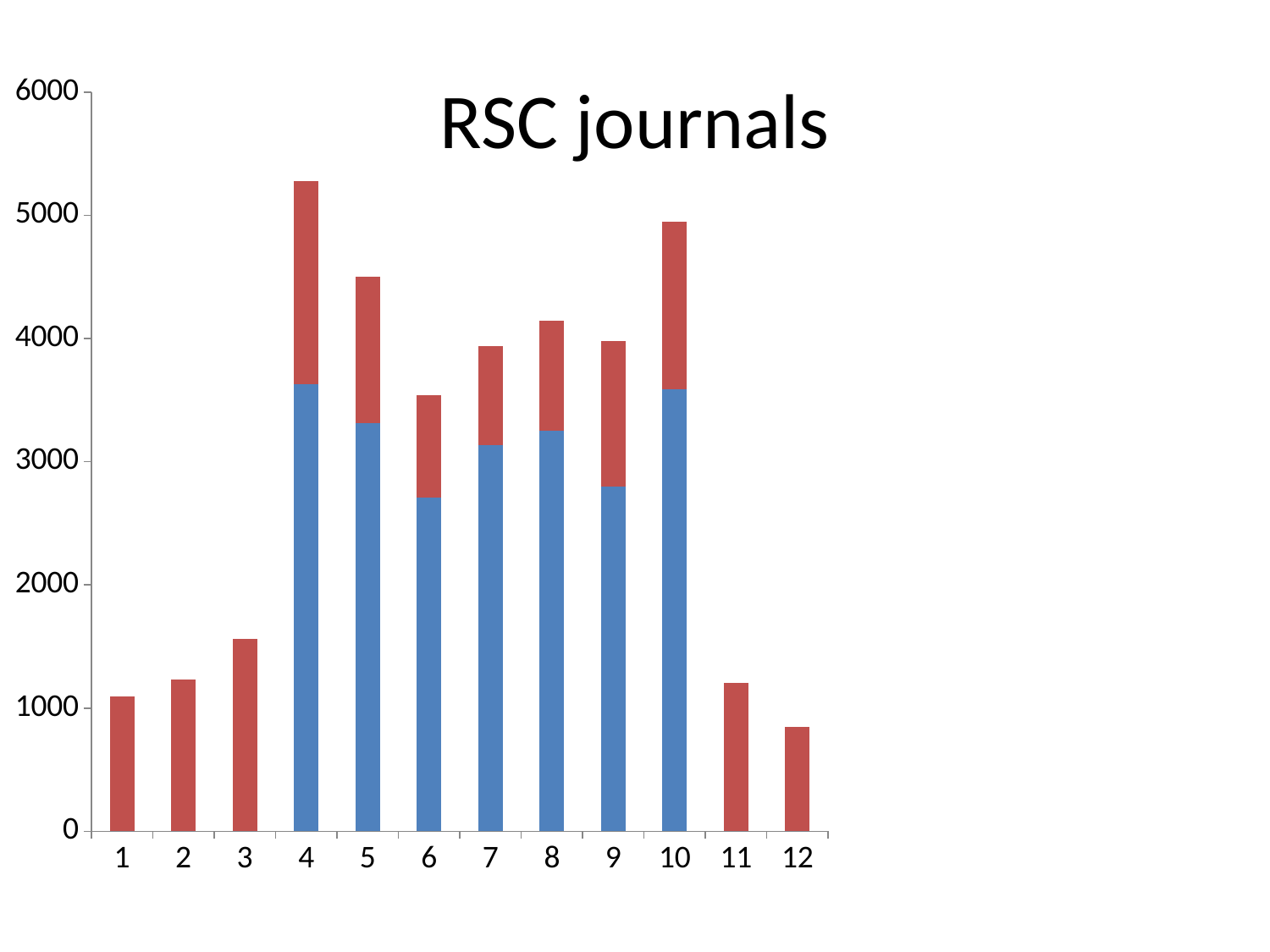
What is the title of the chart? RSC journals Which category has the tallest bar? 4 Is the total value for category 6 greater or less than 4000? less Which bar is taller, category 4 or category 10? 4 Which category has the shortest bar? 12 Is the value for category 12 greater or less than 1000? less Is the total value for category 5 greater or less than 4000? greater Which categories have a blue segment in their bar? 4 to 10 How many categories are shown on the x axis? 12 What kind of chart is shown on the slide? Stacked bar chart